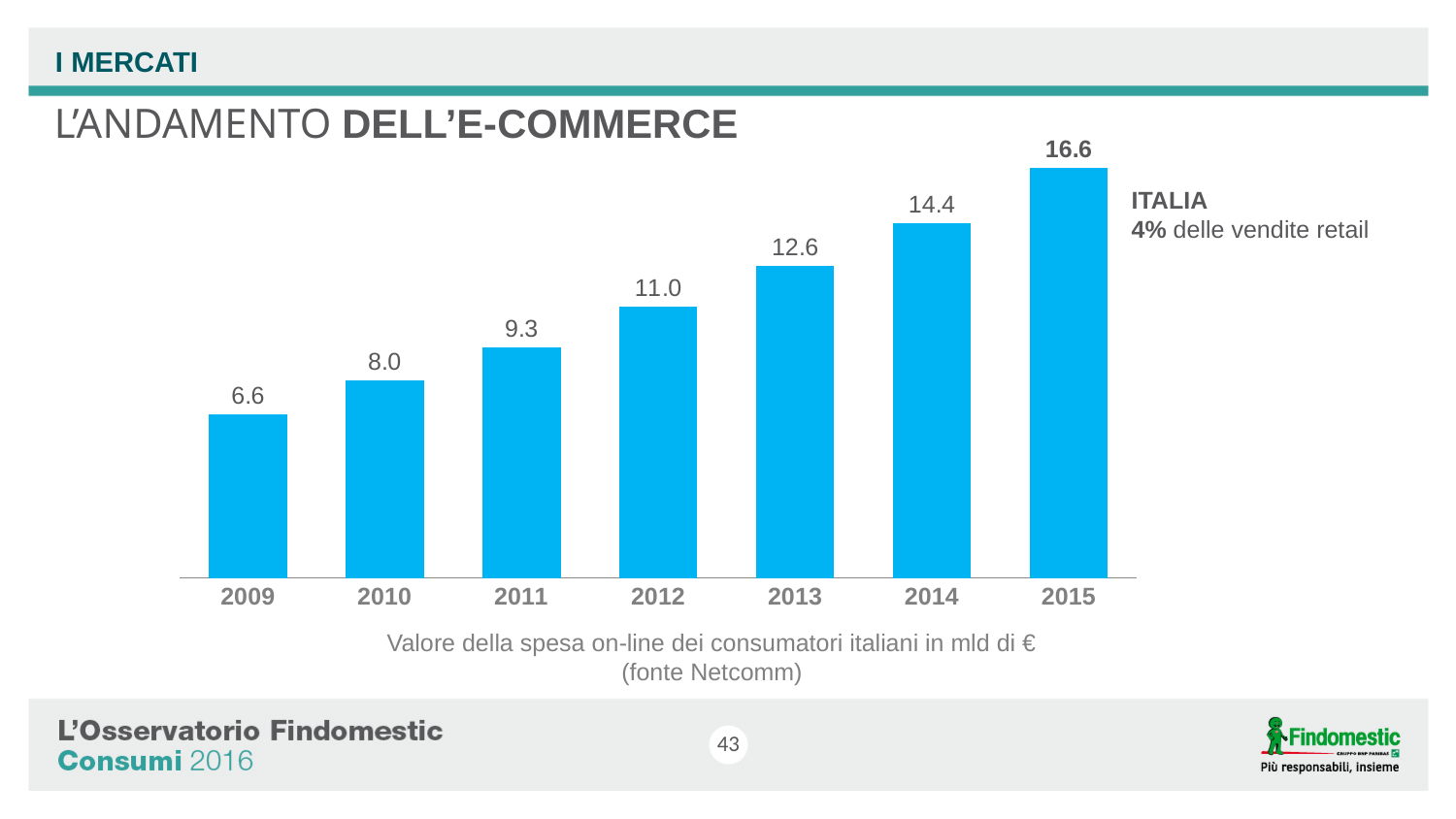
Which is larger, the value for 2013 or the value for 2012? 2013 What is the value for 2015? 16.6 Which year has the lowest value? 2009 According to the chart caption, what is the source of the data? Netcomm What is the value for 2009? 6.6 What is the difference between the values for 2015 and 2014? 2.2 How many years are shown on the chart? 7 What is the value for 2012? 11.0 Which year has the highest value? 2015 What kind of chart is shown on the slide? bar chart What is the difference between the values for 2011 and 2010? 1.3 Do the values rise or fall from 2009 to 2015? rise